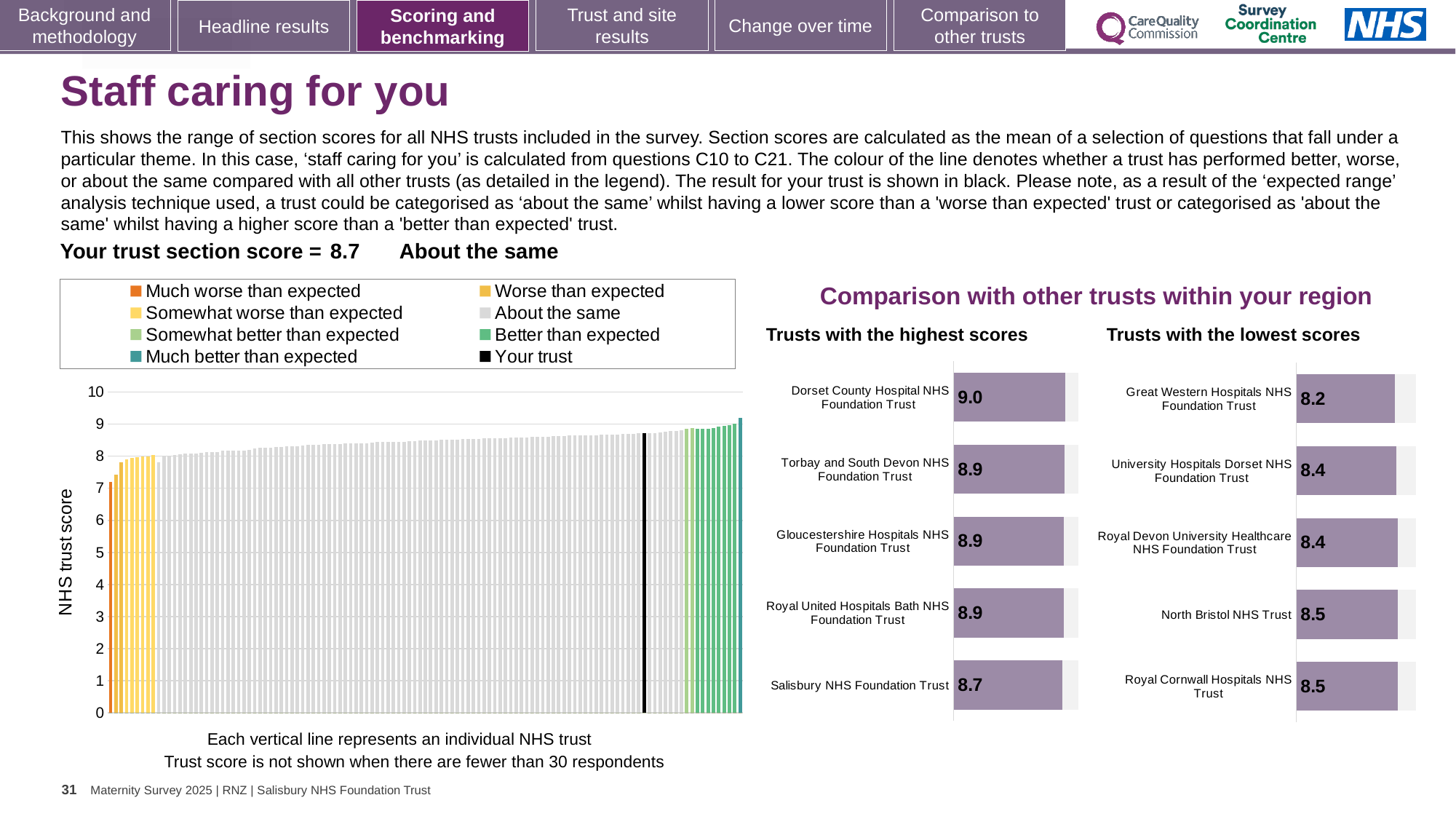
In the 'Trusts with the highest scores' chart, what is the difference between the scores of Dorset County Hospital NHS Foundation Trust and Salisbury NHS Foundation Trust? 0.3 In the main NHS trust score chart, how many entries does the legend list? 8 In the 'Trusts with the lowest scores' chart, which has the larger score: Great Western Hospitals NHS Foundation Trust or Royal Cornwall Hospitals NHS Trust? Royal Cornwall Hospitals NHS Trust In the main NHS trust score chart, is the value of the leftmost (orange) bar greater or less than 8? less How many trusts are listed in the 'Trusts with the highest scores' chart? 5 In the main NHS trust score chart, do the trust scores rise or fall from left to right? Rise In the 'Trusts with the lowest scores' chart, what is the score for North Bristol NHS Trust? 8.5 In the 'Trusts with the highest scores' chart, what is the score for Dorset County Hospital NHS Foundation Trust? 9.0 In the 'Trusts with the highest scores' chart, which trust has the highest score? Dorset County Hospital NHS Foundation Trust What kind of chart is the main NHS trust score chart on the left? Bar chart In the 'Trusts with the lowest scores' chart, which trust has the lowest score? Great Western Hospitals NHS Foundation Trust In the 'Trusts with the lowest scores' chart, what is the score for Great Western Hospitals NHS Foundation Trust? 8.2